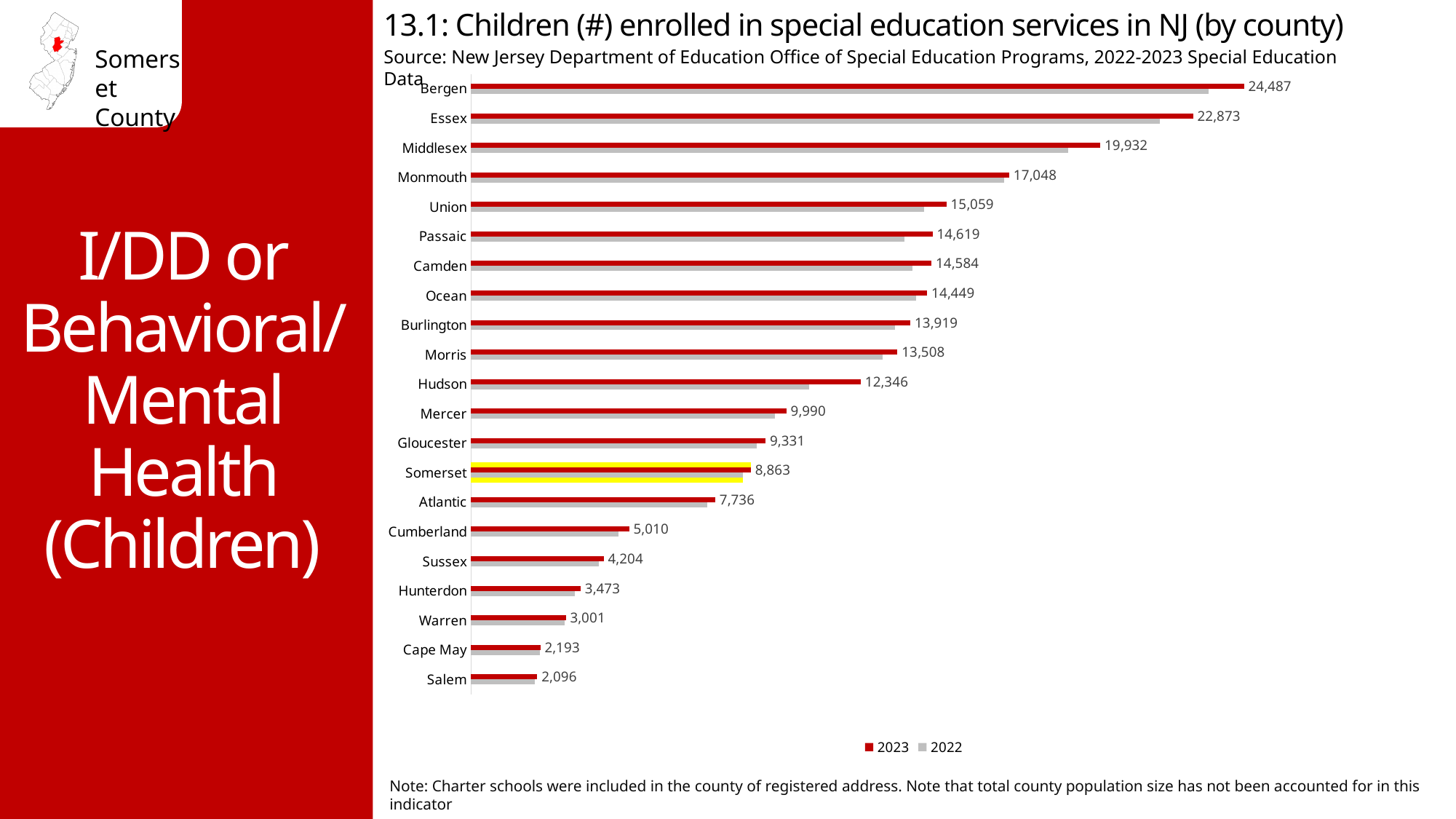
Which colour represents the 2023 series in the chart? Red What is the 2023 value for Somerset county? 8,863 What kind of chart is shown on the slide? Bar chart How many counties are shown in the chart? 21 Which county has the lowest number of children enrolled in special education services in 2023? Salem What is the 2023 value for Bergen county? 24,487 How many series does the legend list? 2 What is the difference between the 2023 values for Bergen and Essex? 1,614 Which county has a larger 2023 value, Hudson or Mercer? Hudson What is the difference between the 2023 values for Somerset and Atlantic? 1,127 What is the 2023 value for Cape May county? 2,193 Which county has the highest number of children enrolled in special education services in 2023? Bergen